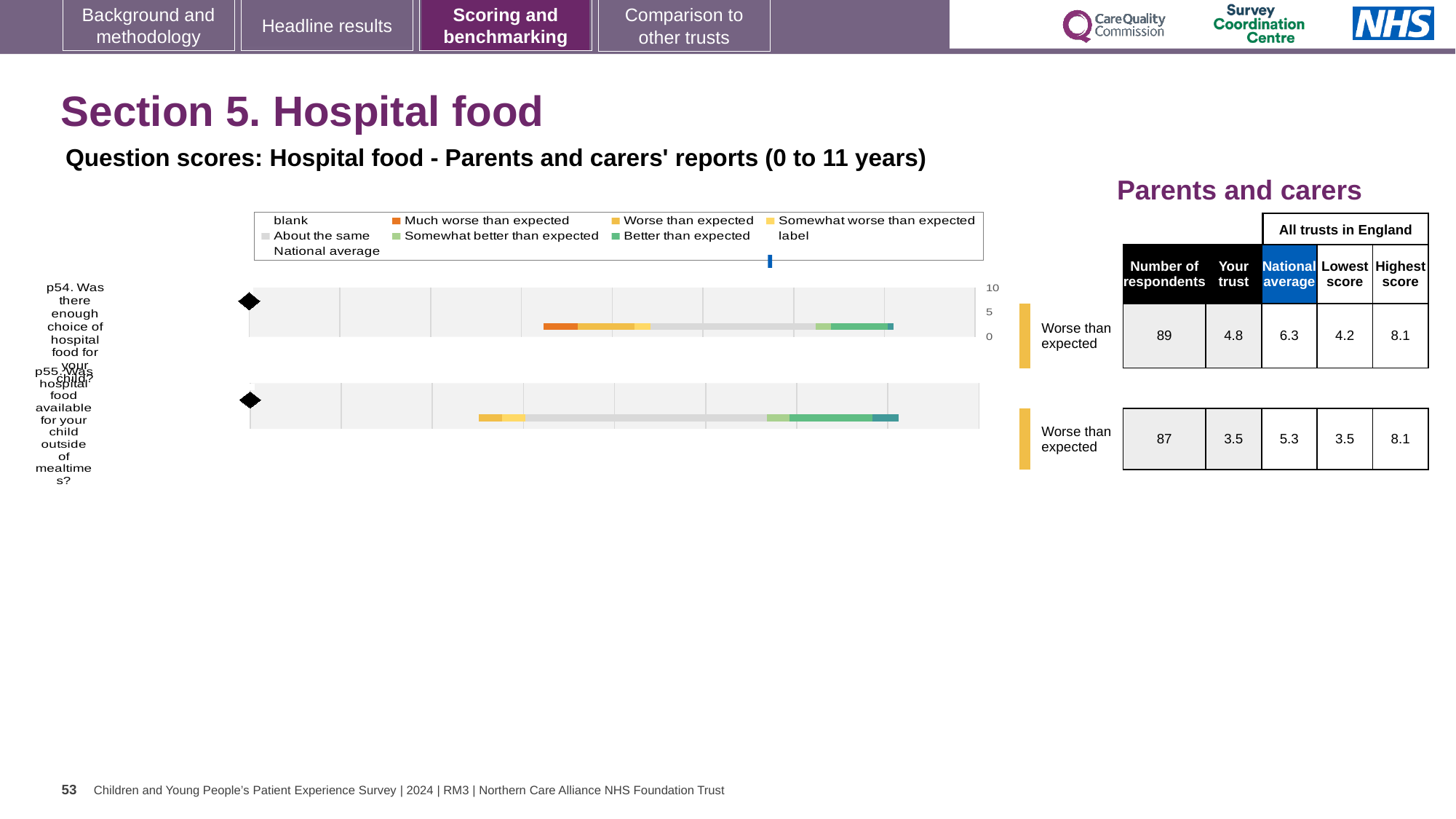
What benchmark label is shown beside both bars in the chart? Worse than expected How many questions (categories) are plotted in the hospital food chart? 2 Which question has the larger number of respondents? p54 What is the highest score among all trusts in England for p54? 8.1 How many respondents answered p55? 87 What type of chart is used to show the question scores for hospital food? bar chart What is the lowest score among all trusts in England for p55? 3.5 What is the 'Your trust' score for p54 (enough choice of hospital food)? 4.8 In the chart legend, what does the orange colour represent? Much worse than expected What is the difference between the national average and the 'Your trust' score for p54? 1.5 What is the national average score for p55 (hospital food available outside of mealtimes)? 5.3 Which question has the higher 'Your trust' score, p54 or p55? p54